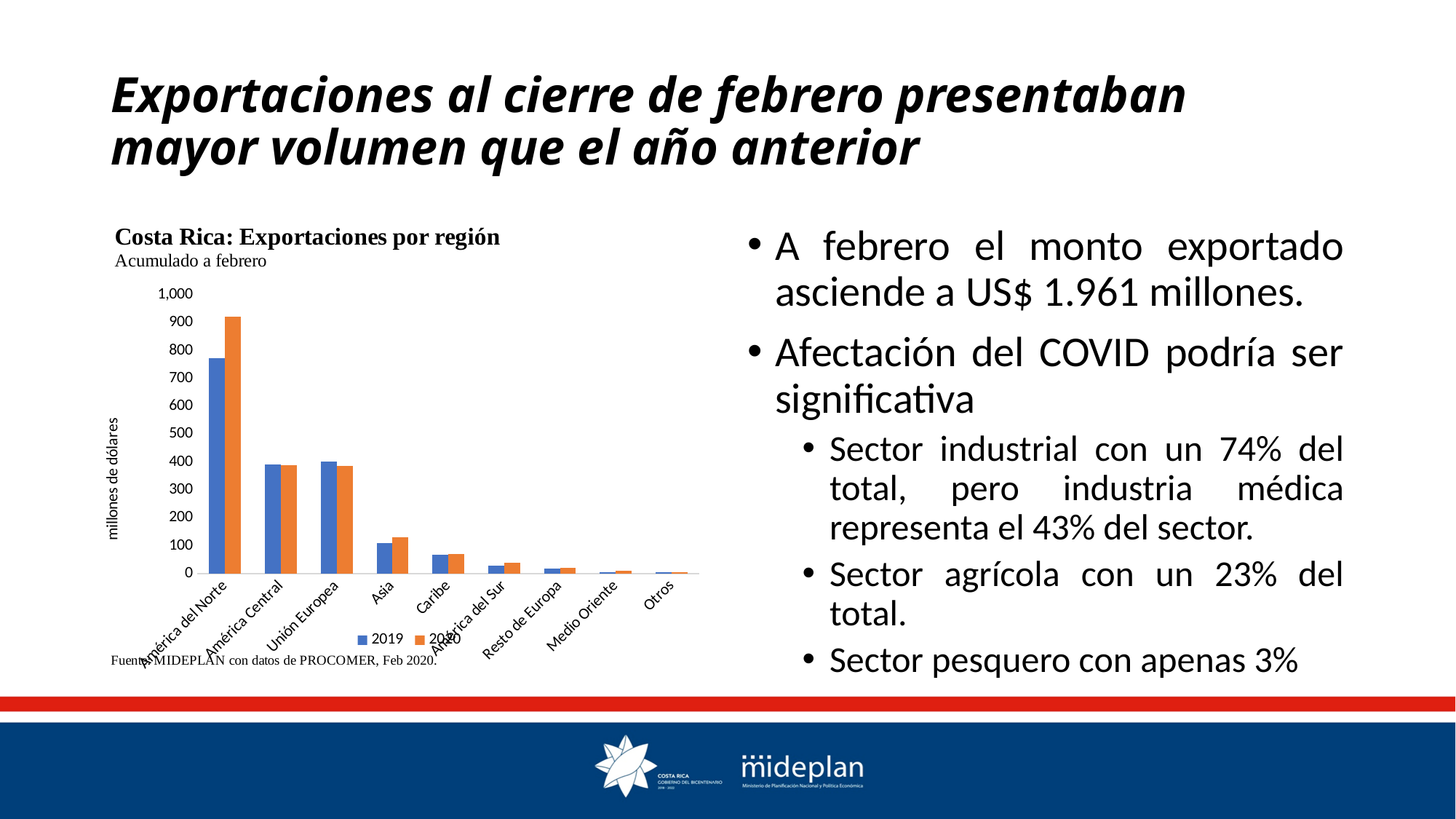
Which region has the highest exports in 2019? América del Norte How many regions are shown on the x axis of the chart? 9 What kind of chart is shown on the slide? bar chart For Asia, which year has the larger value, 2019 or 2020? 2020 Is the 2019 value for América del Norte greater or less than 700? greater Is the 2020 value for Asia greater or less than 200? less Is the 2020 value for América del Norte greater or less than 800? greater For América del Norte, which year has the larger value, 2019 or 2020? 2020 What is the label on the y axis of the chart? millones de dólares How many series does the chart's legend list? 2 Which is larger in 2019, Unión Europea or Asia? Unión Europea Which region has the highest exports in 2020? América del Norte